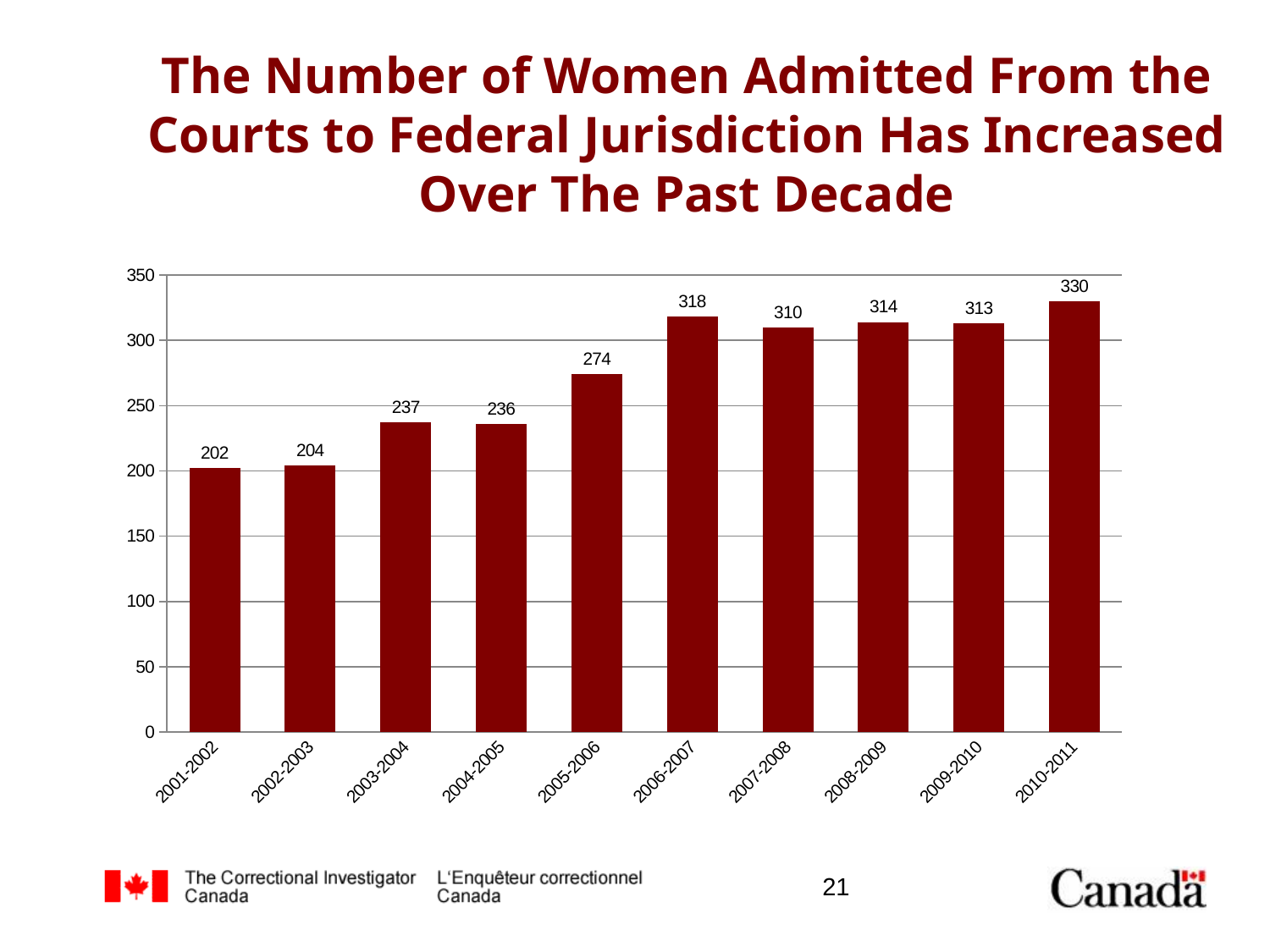
What is the value shown for 2010-2011? 330 What kind of chart is shown on the slide? Bar chart How many years are shown on the x axis? 10 What is the value shown for 2001-2002? 202 What is the difference between the values for 2010-2011 and 2001-2002? 128 Which is larger, the value for 2006-2007 or the value for 2007-2008? 2006-2007 Do the values generally rise or fall from 2001-2002 to 2010-2011? Rise Which year has the highest number of women admitted? 2010-2011 Which year has the lowest number of women admitted? 2001-2002 What is the number of women admitted in 2005-2006? 274 What is the difference between the values for 2006-2007 and 2005-2006? 44 Is the value for 2003-2004 greater or less than 200? greater